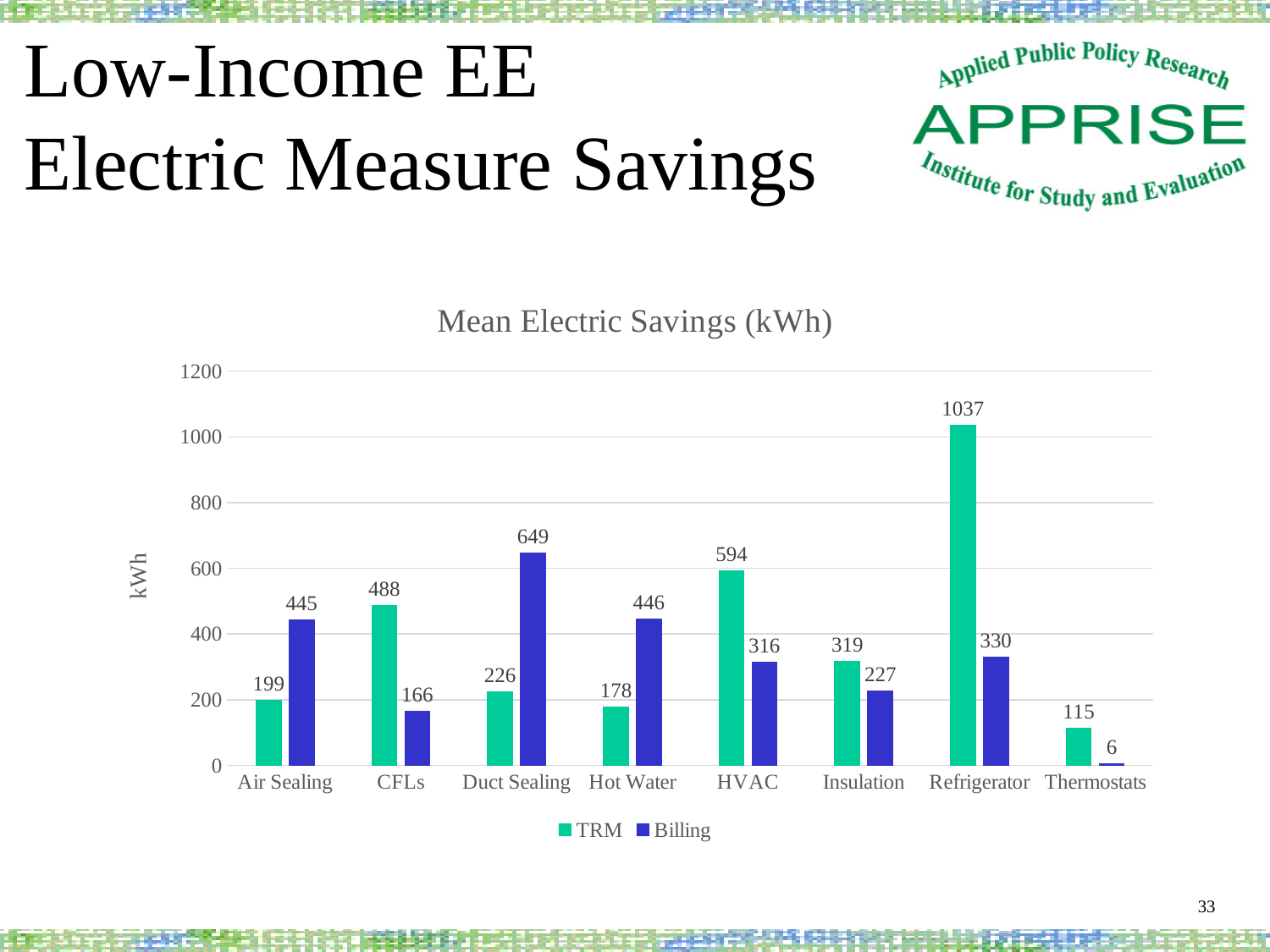
What is the title of the chart? Mean Electric Savings (kWh) What is the difference between the TRM and Billing values for Refrigerator? 707 What is the TRM value for Refrigerator? 1037 Which category has the lowest Billing value? Thermostats How many categories are shown on the x axis? 8 Which is larger for Air Sealing, the TRM value or the Billing value? Billing Which category has the highest TRM value? Refrigerator Is the TRM value for HVAC greater or less than 400? greater How many series does the legend list? 2 What kind of chart is shown? bar chart What is the Billing value for Duct Sealing? 649 What is the Billing value for Thermostats? 6